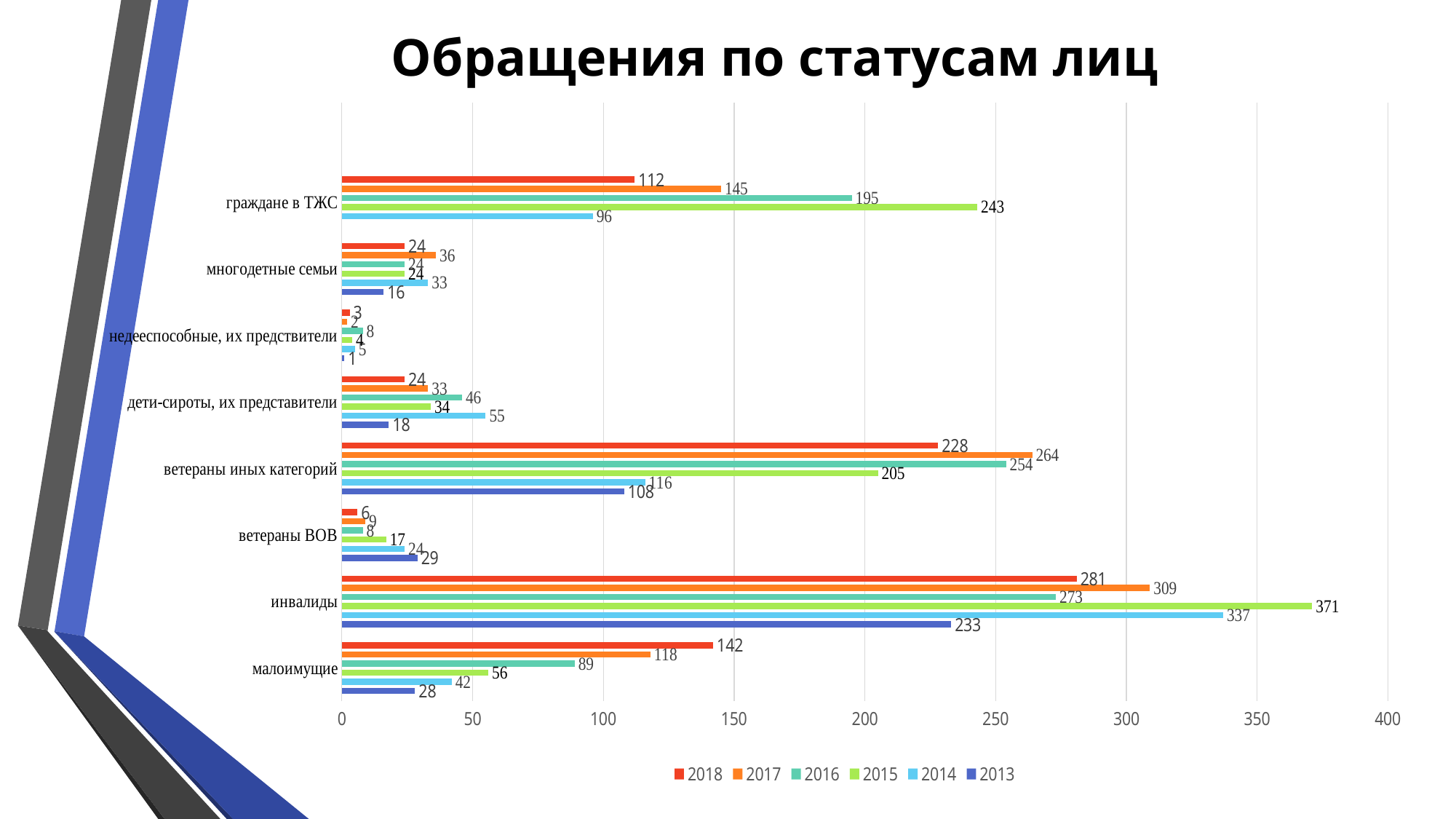
What is the value for граждане в ТЖС in 2016? 195 Which is larger for дети-сироты, их представители: the 2014 value or the 2016 value? 2014 Do the values for малоимущие rise or fall from 2013 to 2018? rise What is the title of the chart? Обращения по статусам лиц What is the value for инвалиды in 2015? 371 What is the value for малоимущие in 2013? 28 How many categories are shown on the vertical axis? 8 What is the difference between the 2018 and 2013 values for ветераны иных категорий? 120 How many series does the legend list? 6 What type of chart is shown on the slide? bar chart Which category has the lowest value in 2013? недееспособные, их предствители Which category has the highest value in 2017? инвалиды